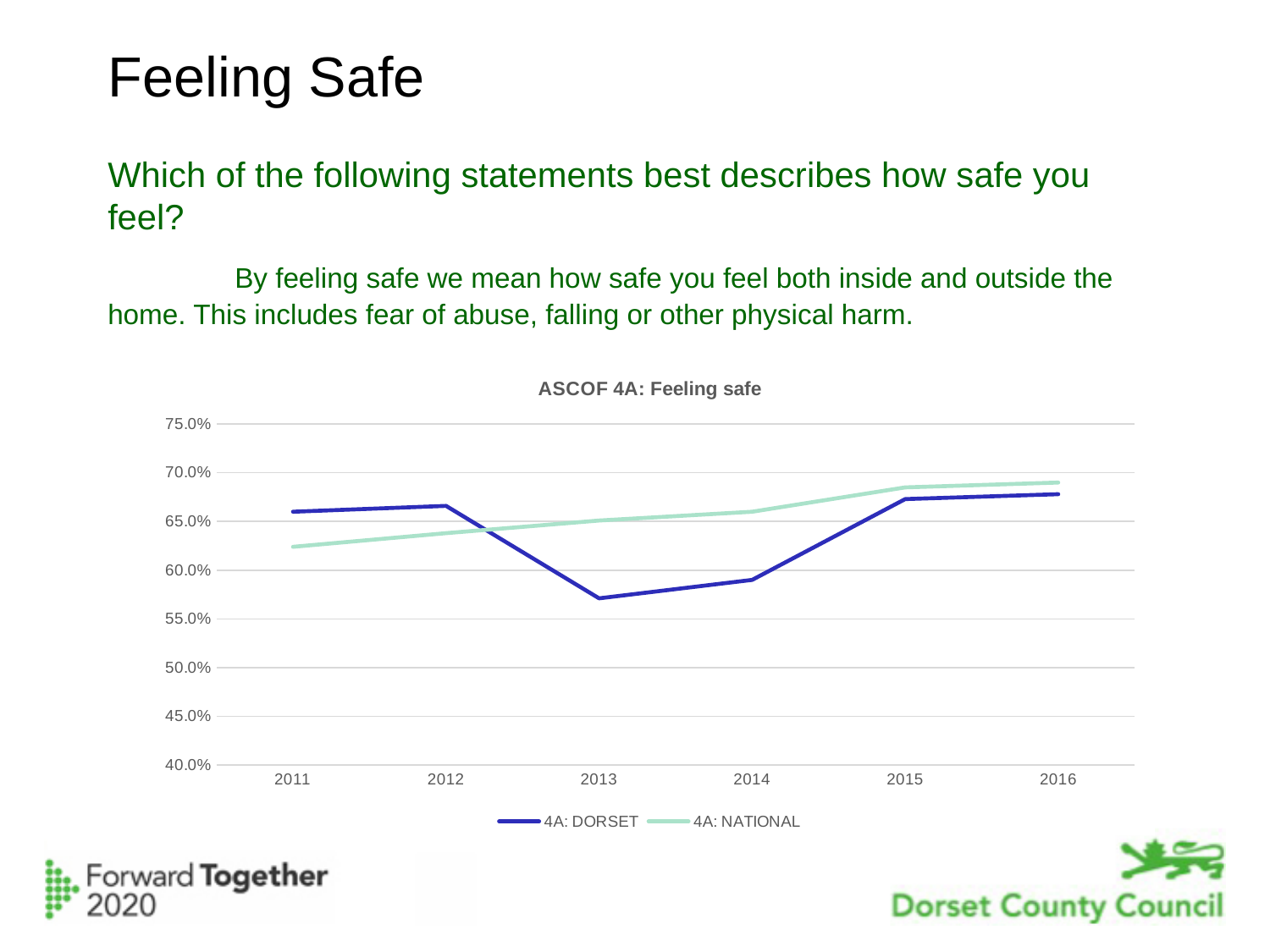
In which year is the 4A: NATIONAL value lowest? 2011 In which year is the 4A: DORSET value lowest? 2013 How many years are shown on the x axis? 6 How many series does the legend list? 2 What is the title of the chart? ASCOF 4A: Feeling safe In 2013, which series has the higher value, 4A: DORSET or 4A: NATIONAL? 4A: NATIONAL What kind of chart is shown on the slide? line chart Is the 4A: DORSET value for 2013 greater or less than 60.0%? less Is the 4A: NATIONAL value for 2016 greater or less than 70.0%? less Which series is drawn in dark blue? 4A: DORSET Does the 4A: NATIONAL line rise or fall from 2011 to 2016? rise Is the 4A: NATIONAL value for 2011 greater or less than 60.0%? greater